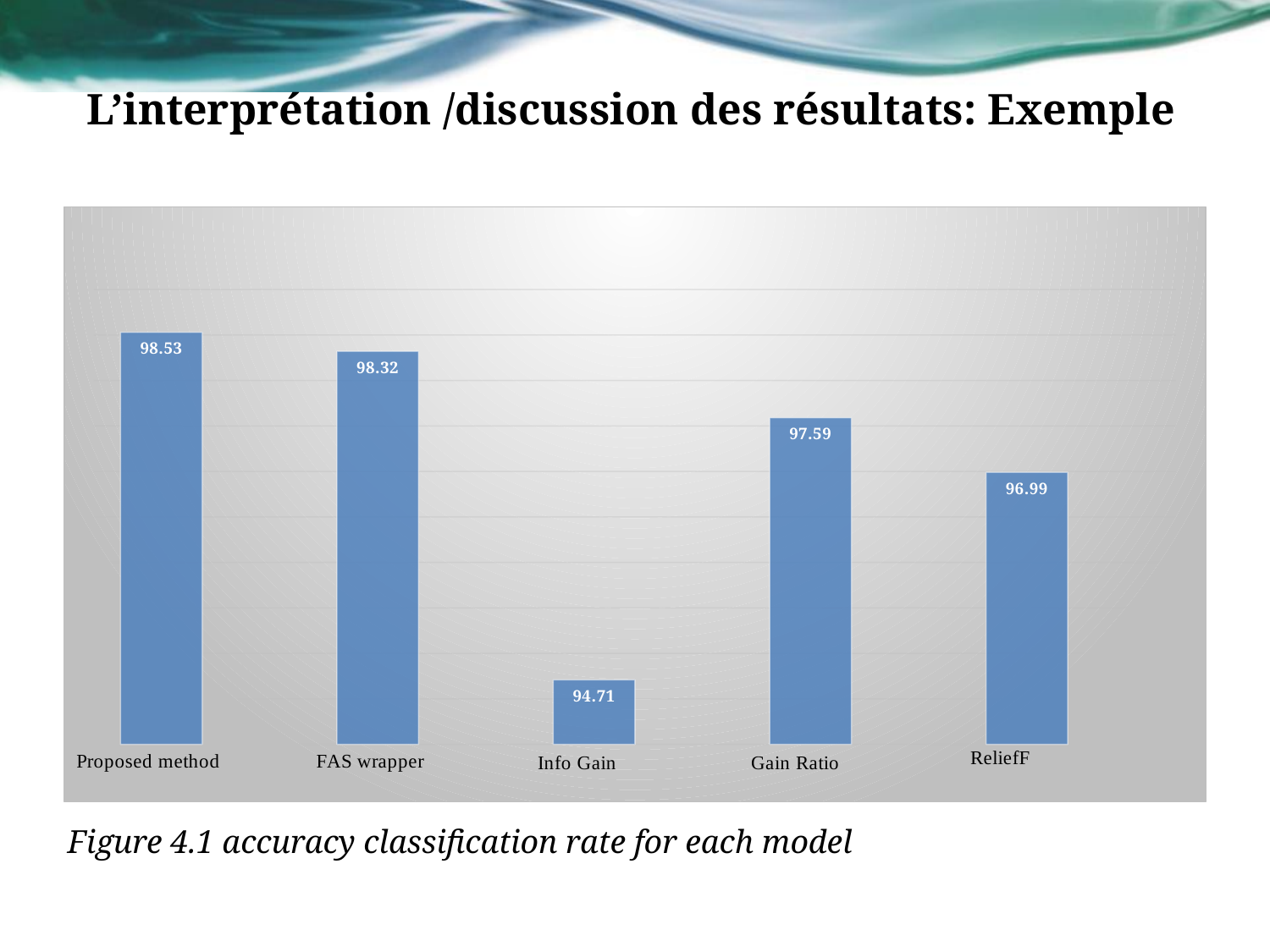
What is the value for Info Gain? 94.71 What is the difference between the values for Proposed method and Info Gain? 3.82 Which category has the highest value? Proposed method What is the value for ReliefF? 96.99 What is the value for Gain Ratio? 97.59 What is the difference between the values for Gain Ratio and ReliefF? 0.60 Which is larger, the value for Gain Ratio or the value for ReliefF? Gain Ratio Which category has the lowest value? Info Gain What is the value for FAS wrapper? 98.32 How many categories are shown in the chart? 5 What is the value for Proposed method? 98.53 What kind of chart is shown on the slide? Bar chart